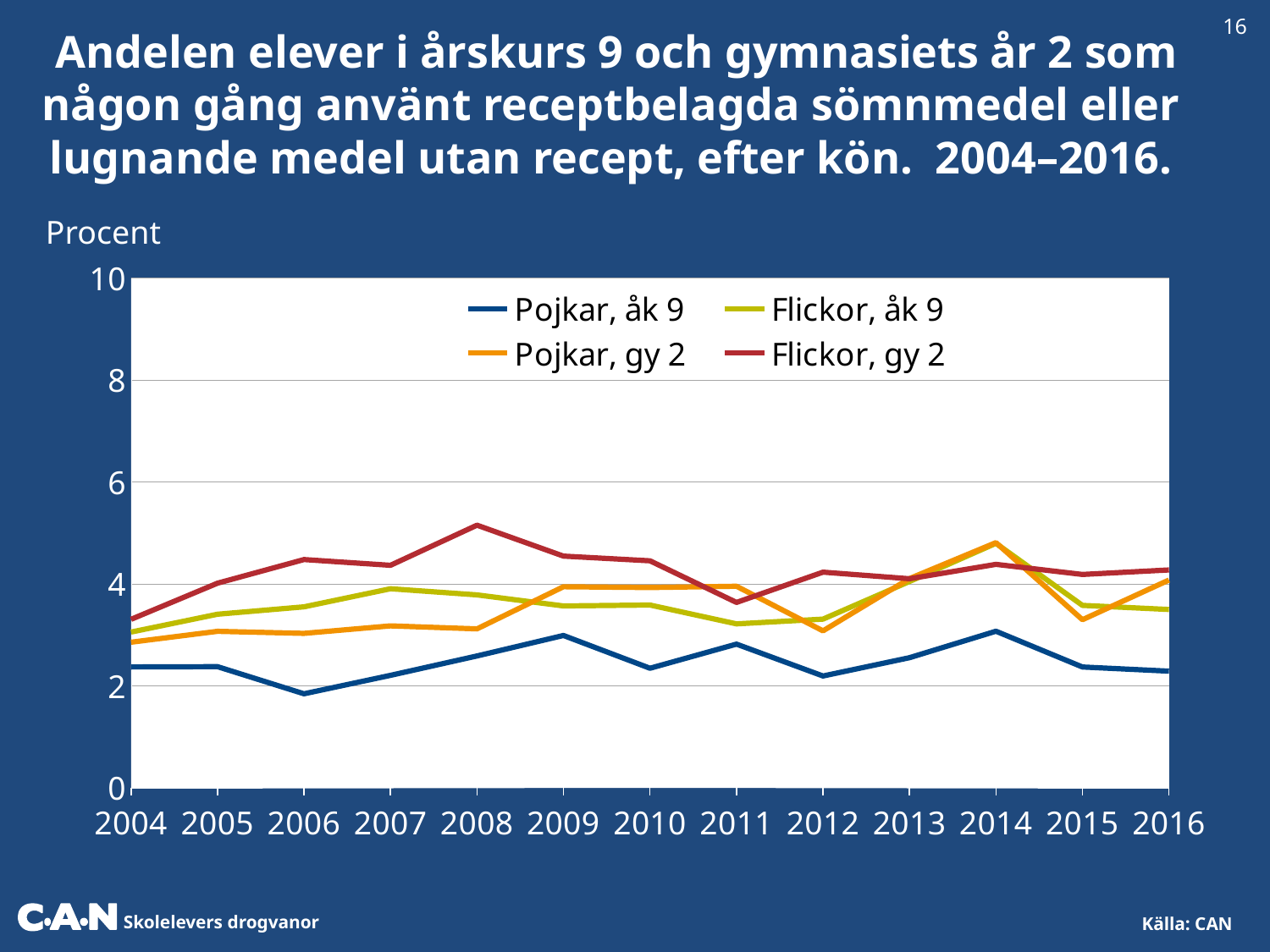
Does the value for Flickor, gy 2 rise or fall from 2004 to 2008? rise Which series has the highest value in 2008? Flickor, gy 2 How many series does the legend list? 4 In 2014, which is larger: Pojkar, gy 2 or Pojkar, åk 9? Pojkar, gy 2 What label is shown above the y axis? Procent Is the value for Flickor, gy 2 in 2008 greater or less than 4? greater Is the value for Pojkar, åk 9 in 2012 greater or less than 4? less Is the value for Pojkar, gy 2 in 2014 greater or less than 4? greater Which series are listed in the legend? Pojkar, åk 9; Pojkar, gy 2; Flickor, åk 9; Flickor, gy 2 How many years are shown along the x axis? 13 Which series has the lowest value in every year shown? Pojkar, åk 9 What kind of chart is shown on the slide? line chart